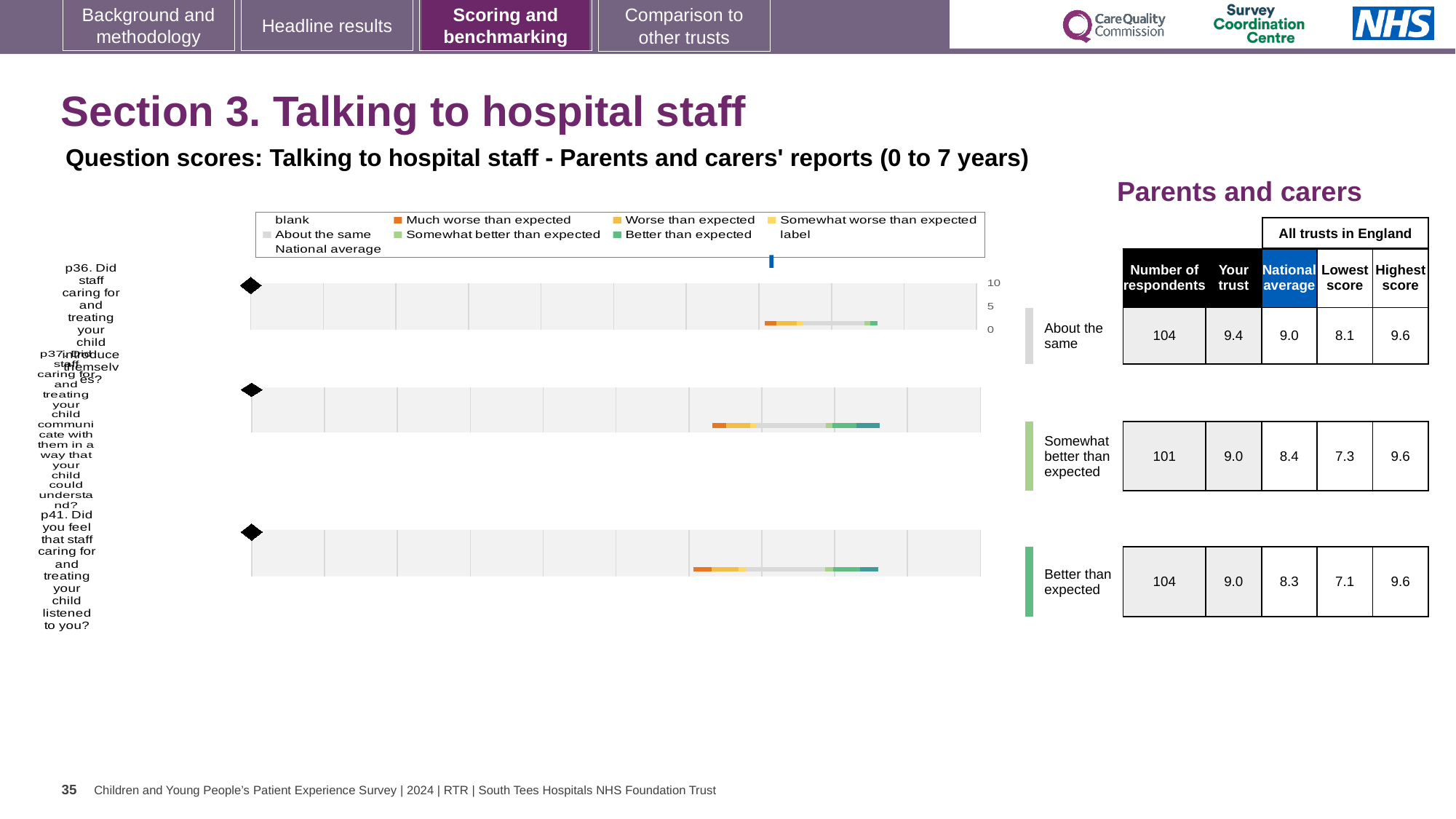
How many survey questions (categories) are plotted in the chart? 3 What is the maximum value shown on the chart's score axis? 10 Which benchmark category is p37 rated as? Somewhat better than expected Is the 'Your trust' score for p41 greater or less than 5? greater What is the difference between the 'Your trust' score and the national average for p36? 0.4 Which question has the highest 'Your trust' score? p36 What kind of chart is used to show the question scores on this slide? Bar chart What is the 'Your trust' score for p36 (Did staff caring for and treating your child introduce themselves)? 9.4 How many respondents answered p37 (Did staff communicate with them in a way that your child could understand)? 101 Which question has the lowest 'Lowest score' across all trusts in England? p41 Which colour in the legend represents 'Much worse than expected'? Orange What is the national average score for p41 (Did you feel that staff caring for and treating your child listened to you)? 8.3